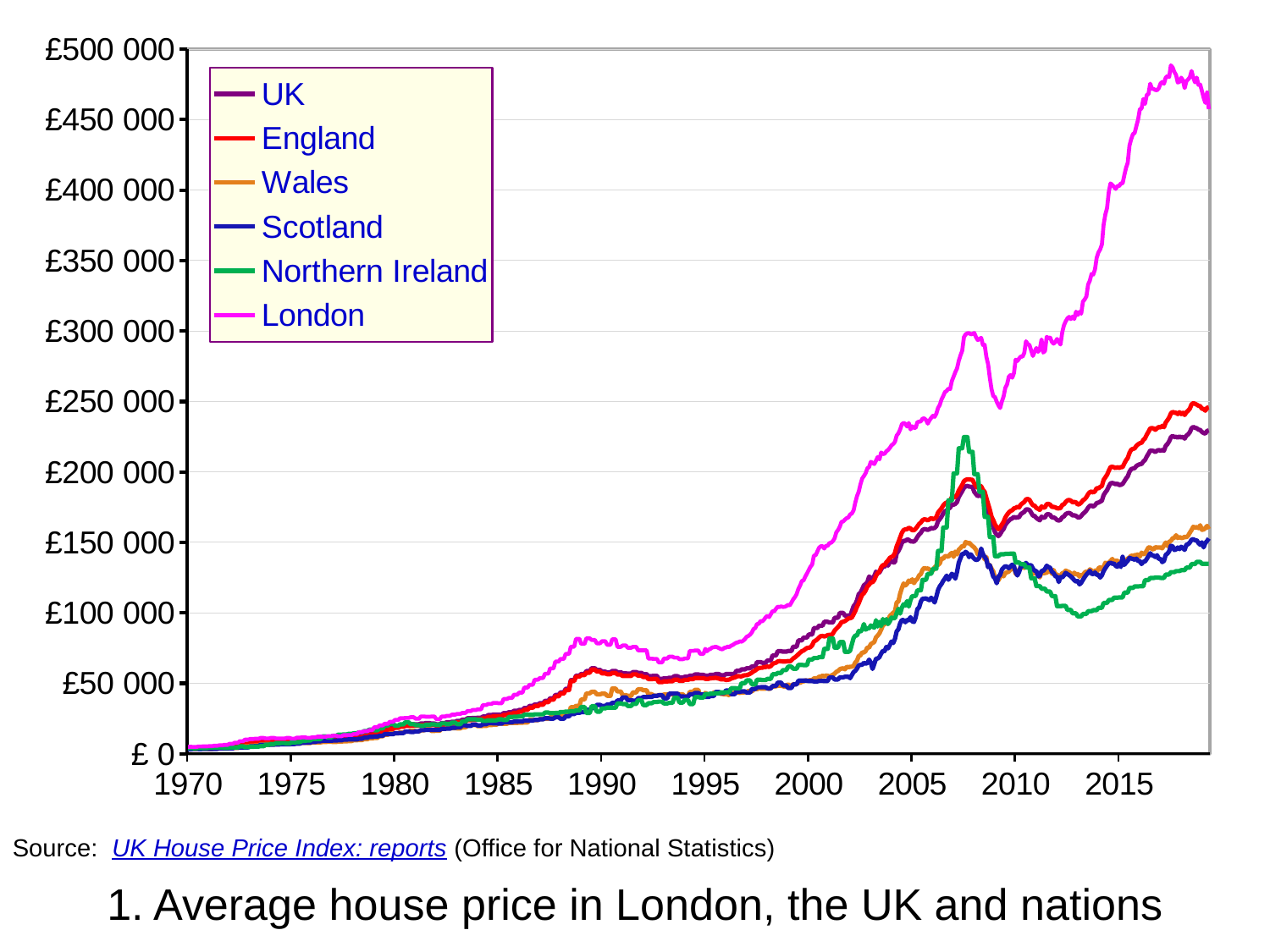
Is the value for Scotland in 2000 greater or less than £100 000? less Is the value for England in 2019 greater or less than £200 000? greater How many series does the legend list? 6 In 2019, which is higher, England or Scotland? England Is the value for London in 2017 greater or less than £450 000? greater Which series has the highest value at the end of the period (around 2019)? London What kind of chart is shown on the slide? line chart Did the London series rise or fall between 2008 and 2009? fall Which series has the lowest value at the end of the period (around 2019)? Northern Ireland What is the title of the chart? 1. Average house price in London, the UK and nations Does the London series overall rise or fall from 1970 to 2019? rise